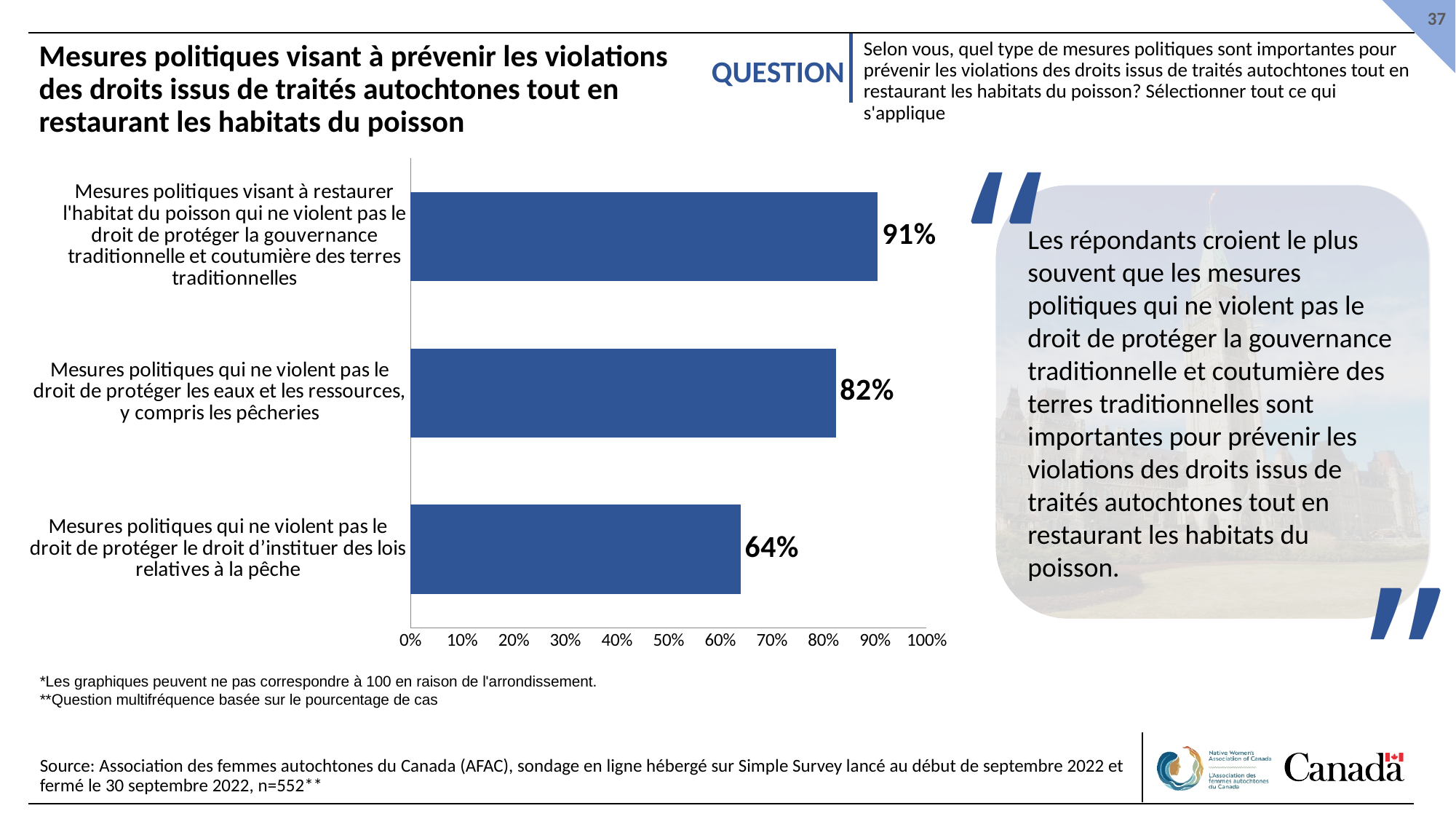
What is the value for 'Mesures politiques qui ne violent pas le droit de protéger le droit d'instituer des lois relatives à la pêche'? 64% What kind of chart is shown on the slide? bar chart Is the value for 'Mesures politiques qui ne violent pas le droit de protéger le droit d'instituer des lois relatives à la pêche' greater or less than 70%? less Which category has the highest value? Mesures politiques visant à restaurer l'habitat du poisson qui ne violent pas le droit de protéger la gouvernance traditionnelle et coutumière des terres traditionnelles What is the value for 'Mesures politiques visant à restaurer l'habitat du poisson qui ne violent pas le droit de protéger la gouvernance traditionnelle et coutumière des terres traditionnelles'? 91% What is the maximum value shown on the horizontal axis of the chart? 100% How many categories are shown on the chart? 3 What is the difference between the value for the category about protecting waters and resources (82%) and the category about restoring fish habitat (91%)? 9% What is the value for 'Mesures politiques qui ne violent pas le droit de protéger les eaux et les ressources, y compris les pêcheries'? 82% What is the difference between the highest and lowest values on the chart? 27% Which category has the lowest value? Mesures politiques qui ne violent pas le droit de protéger le droit d'instituer des lois relatives à la pêche Which is larger: the value for the category about protecting waters and resources, or the category about the right to institute fishing laws? Mesures politiques qui ne violent pas le droit de protéger les eaux et les ressources, y compris les pêcheries